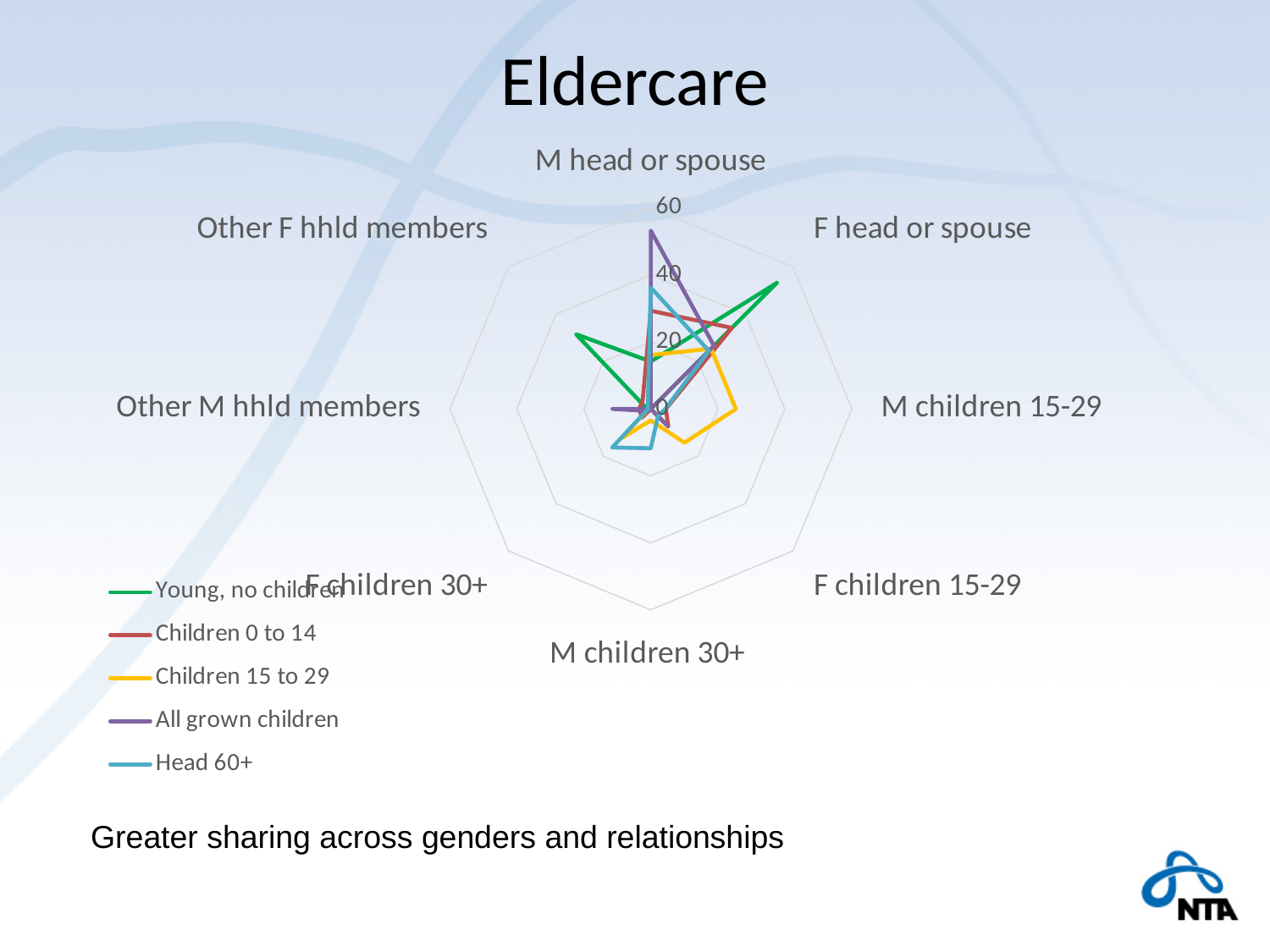
Is the value for Young, no children at F head or spouse greater or less than 40? greater How many series does the legend list? 5 What is the highest value shown on the radar chart's axis scale? 60 Is the value for All grown children at M head or spouse greater or less than 40? greater Is the value for Children 15 to 29 at M head or spouse greater or less than 20? less At M head or spouse, which is larger: All grown children or Children 15 to 29? All grown children For the Young, no children series, which category has the highest value? F head or spouse What kind of chart is shown on the slide? Radar chart Which series has the highest value at M head or spouse? All grown children What is the title of the chart? Eldercare How many categories (axes) does the radar chart have? 8